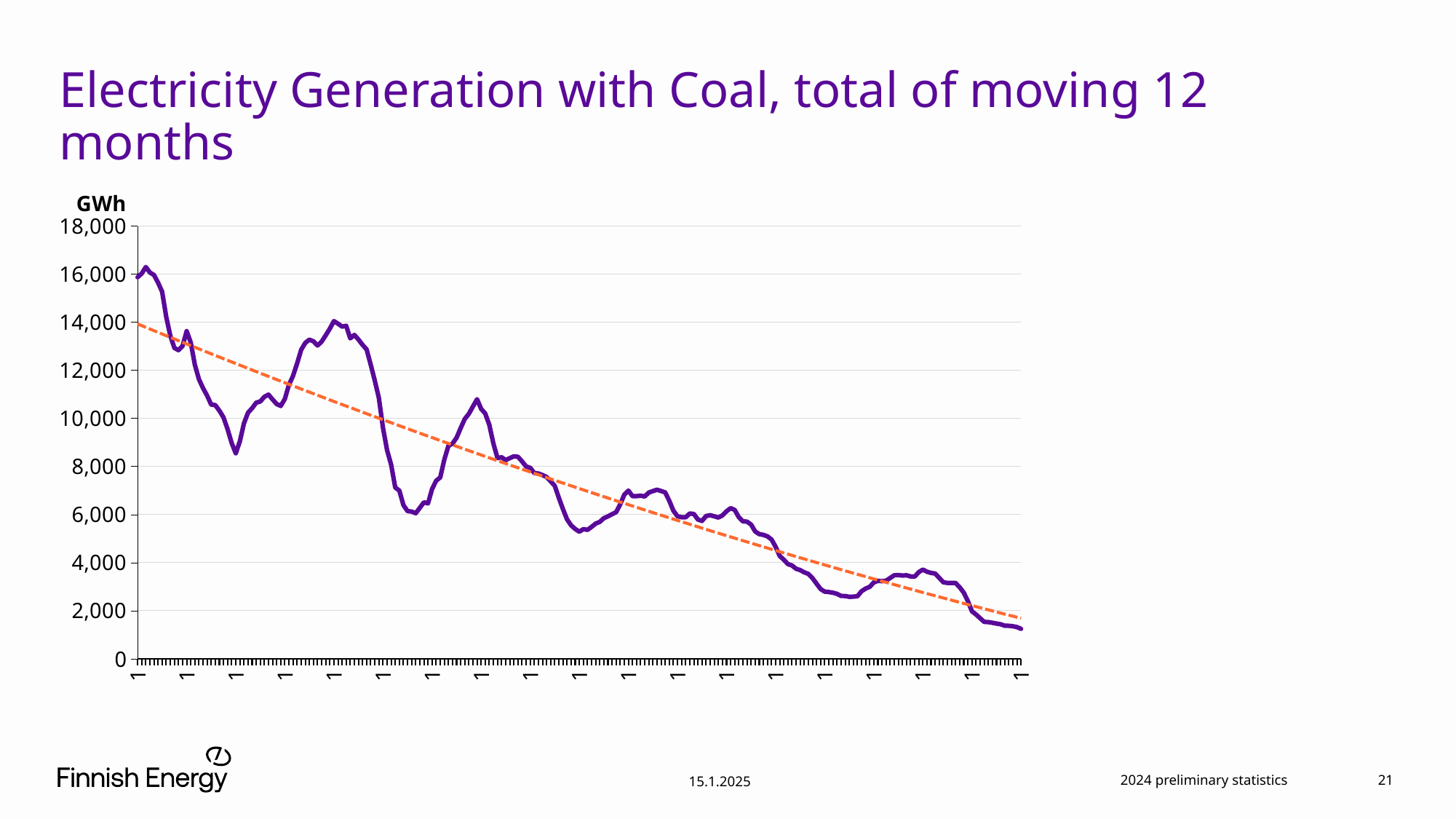
What kind of chart is shown on the slide? line chart Is the value of the purple line at the start of the series greater or less than the value at the end of the series? greater What unit is shown on the vertical axis of the chart? GWh Is the value of the purple line at the start of the series (far left) greater or less than 14,000? greater Is the value of the orange dashed line at the far left of the chart greater or less than 12,000? greater Is the value of the purple line at the end of the series (far right) greater or less than 2,000? less What is the title of the chart? Electricity Generation with Coal, total of moving 12 months Do the values of the purple line generally rise or fall from left to right along the x axis? fall What is the highest value shown on the vertical axis of the chart? 18,000 Does the orange dashed trend line slope upward or downward from left to right? downward